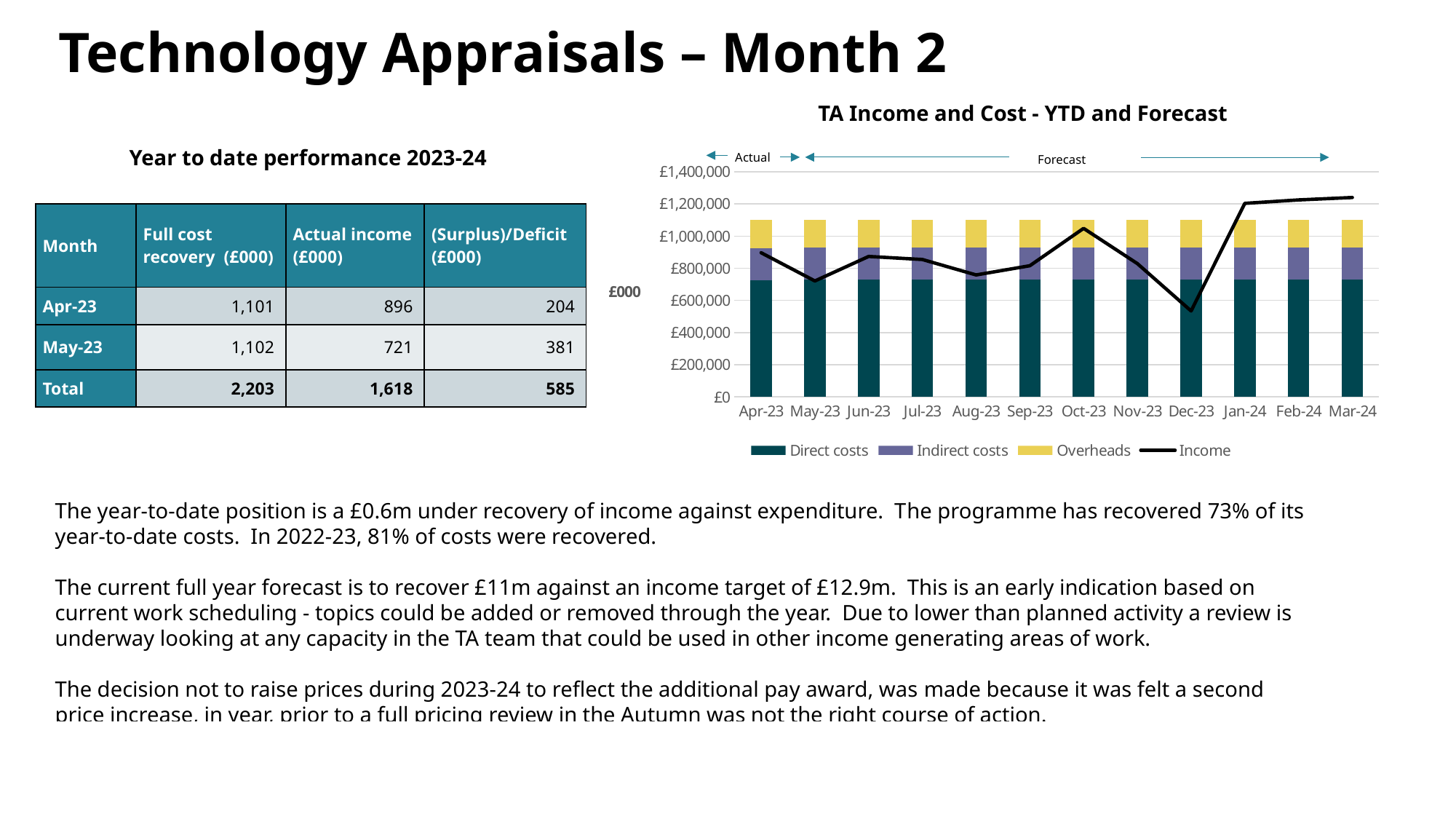
What kind of chart is 'TA Income and Cost - YTD and Forecast'? Stacked bar chart with a line How many series does the legend of the 'TA Income and Cost - YTD and Forecast' chart list? 4 In the 'TA Income and Cost - YTD and Forecast' chart, is the Income for Jan-24 greater or less than £1,000,000? greater How many months are shown on the x axis of the 'TA Income and Cost - YTD and Forecast' chart? 12 In the 'TA Income and Cost - YTD and Forecast' chart, which month has the lowest Income? Dec-23 In the 'TA Income and Cost - YTD and Forecast' chart, which month has the highest Income? Mar-24 In the 'TA Income and Cost - YTD and Forecast' chart, does the Income line rise or fall from Dec-23 to Mar-24? rise What are the legend entries of the 'TA Income and Cost - YTD and Forecast' chart? Direct costs, Indirect costs, Overheads, Income In the 'TA Income and Cost - YTD and Forecast' chart, is the Income for Dec-23 greater or less than £600,000? less In the 'TA Income and Cost - YTD and Forecast' chart, which series forms the bottom segment of each stacked bar? Direct costs In the 'TA Income and Cost - YTD and Forecast' chart, is the Income higher in Oct-23 or in Dec-23? Oct-23 In the 'TA Income and Cost - YTD and Forecast' chart, is the Income for May-23 greater or less than £800,000? less